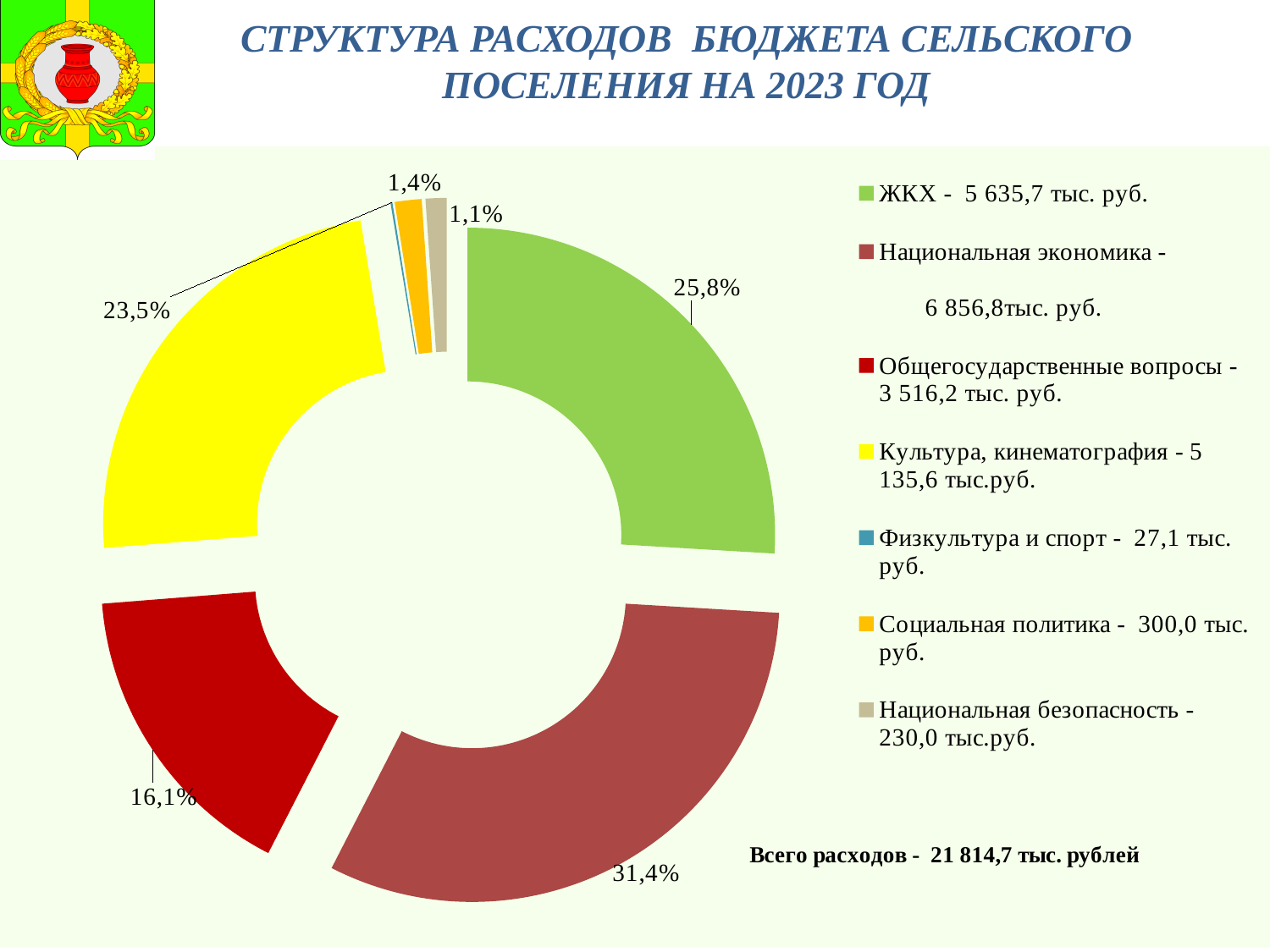
What percentage share does the Культура, кинематография slice have? 23,5% How many categories does the legend list? 7 What percentage share does the Общегосударственные вопросы slice have? 16,1% What is the difference in percentage points between the Национальная экономика share and the ЖКХ share? 5,6% Which is larger: the share for Культура, кинематография or the share for Общегосударственные вопросы? Культура, кинематография What percentage share does the ЖКХ slice have? 25,8% According to the legend, what is the amount for Социальная политика? 300,0 тыс. руб. What percentage share does the Национальная экономика slice have? 31,4% Which category has the largest share of expenditures? Национальная экономика What kind of chart is shown on the slide? Doughnut (pie) chart What total expenditure amount is stated on the slide? 21 814,7 тыс. рублей Which category has the smallest amount in the legend? Физкультура и спорт